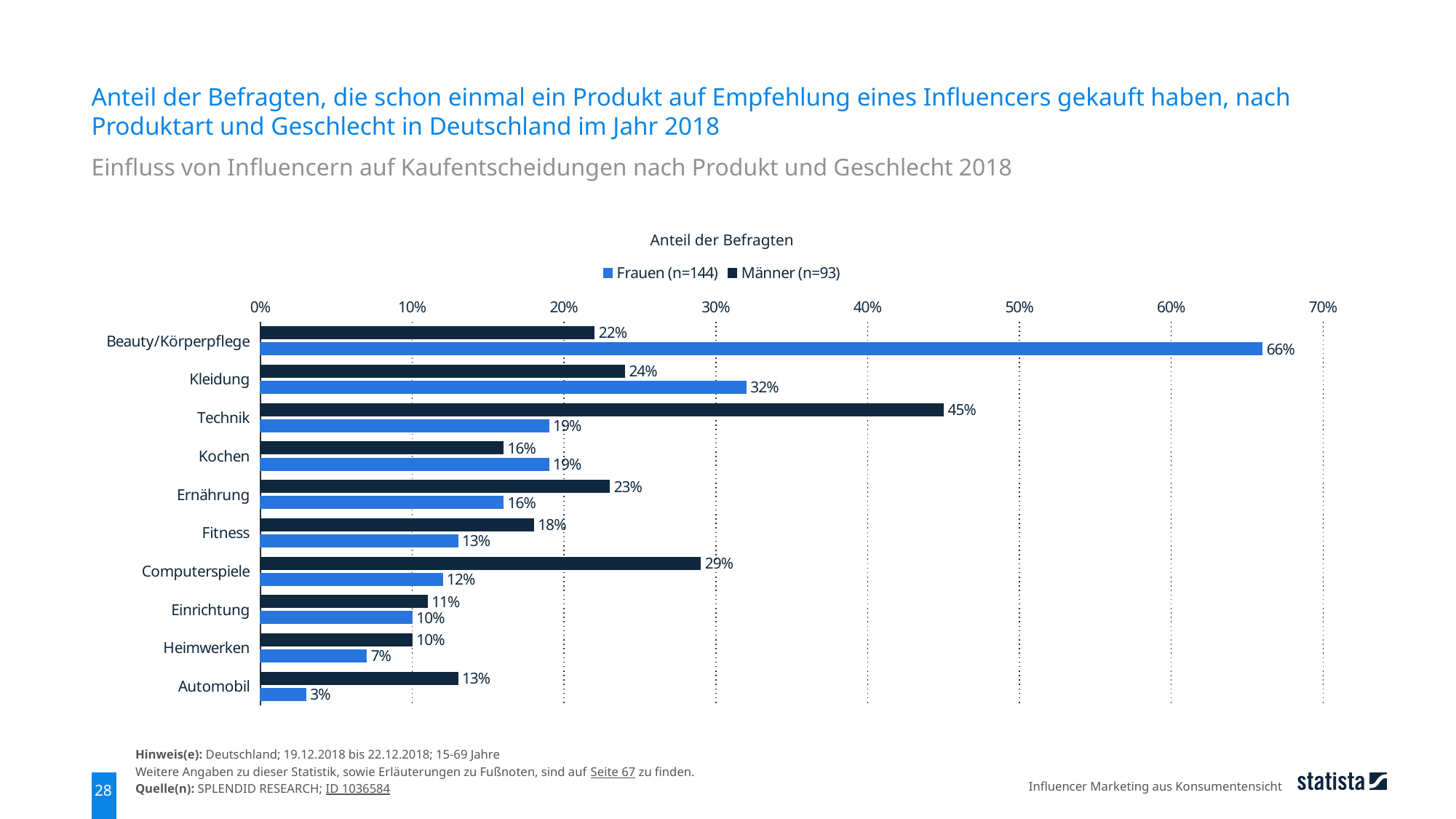
What is the value for Frauen (n=144) in the Automobil category? 3% What is the difference between the Frauen (n=144) and Männer (n=93) values for Beauty/Körperpflege? 44% Which category has the highest value for Männer (n=93)? Technik What kind of chart is shown on the slide? Bar chart How many product categories are shown on the chart? 10 Which is larger for Computerspiele: the value for Frauen (n=144) or for Männer (n=93)? Männer (n=93) What is the axis title shown above the chart? Anteil der Befragten What is the value for Frauen (n=144) in the Beauty/Körperpflege category? 66% Which category has the lowest value for Frauen (n=144)? Automobil What is the value for Männer (n=93) in the Ernährung category? 23% How many series does the legend list? 2 What is the value for Männer (n=93) in the Technik category? 45%